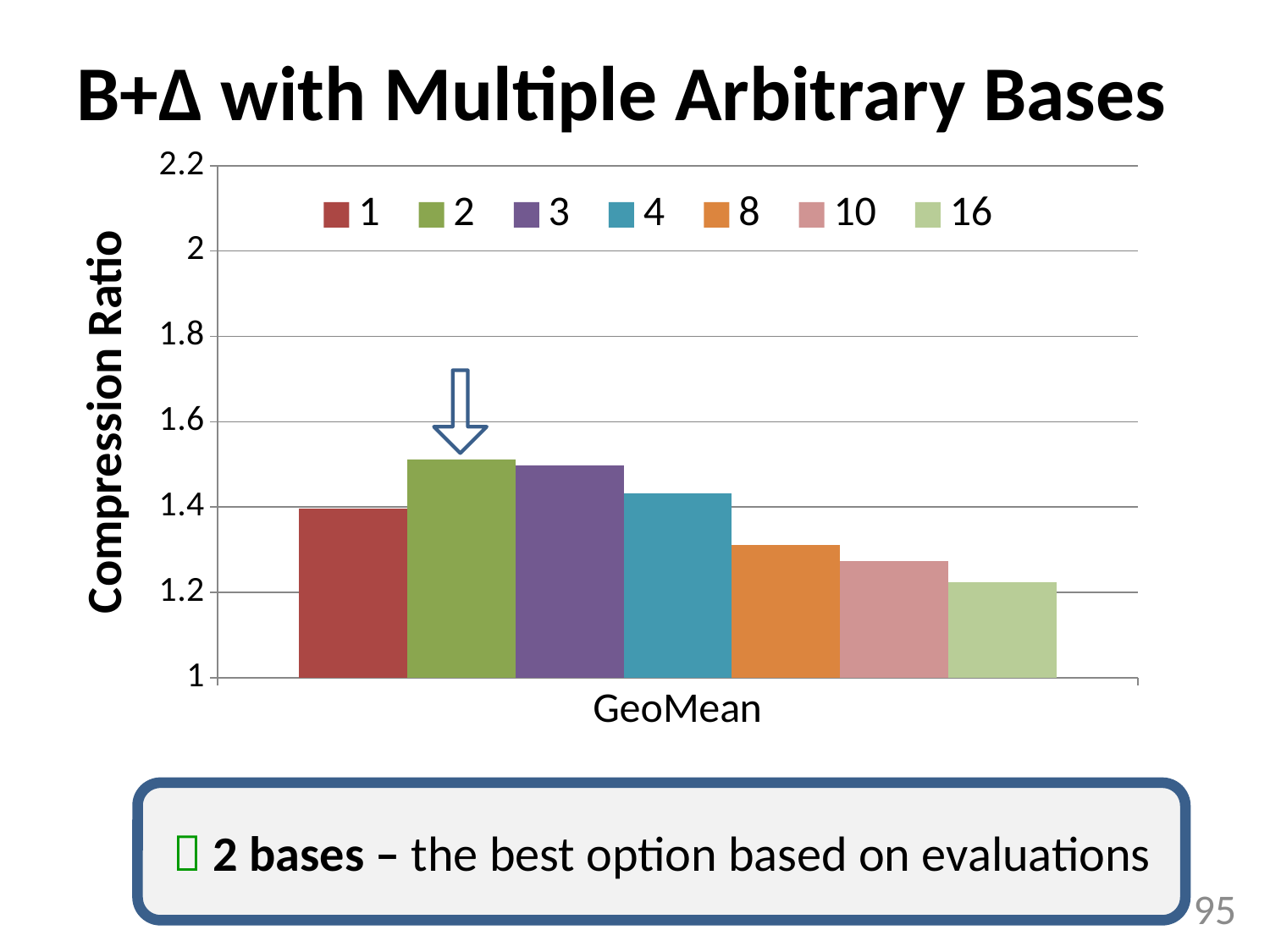
Which has a higher compression ratio, series 4 or series 8? 4 Which has a higher compression ratio, series 1 or series 16? 1 Is the compression ratio for series 3 greater or less than 1.6? less Is the compression ratio for series 8 greater or less than 1.4? less Which series has the lowest compression ratio for GeoMean? 16 Which series has the highest compression ratio for GeoMean? 2 Is the compression ratio for series 2 greater or less than 1.4? greater How many categories are shown on the x axis? 1 What is the label of the y axis? Compression Ratio What kind of chart is shown on the slide? bar chart How many series does the legend list? 7